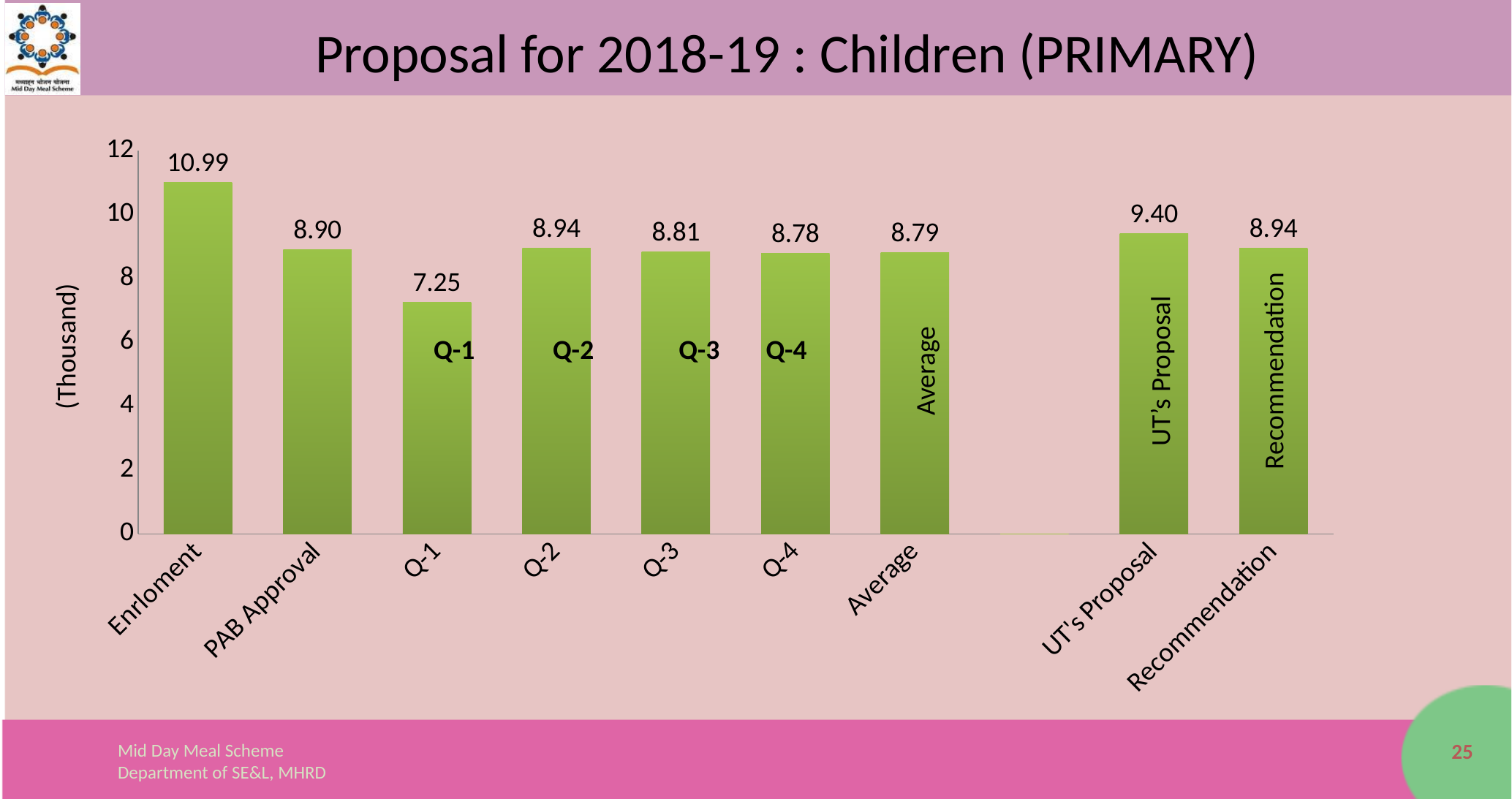
What is the difference between the Enrolment value and the PAB Approval value? 2.09 What is the value for Recommendation? 8.94 What is the label on the vertical axis? (Thousand) Which category has the lowest value? Q-1 What is the value for UT's Proposal? 9.40 What is the value for Enrolment? 10.99 What is the value for PAB Approval? 8.90 How many labelled categories are shown on the x axis? 9 Which category has the highest value? Enrolment Which is larger, the value for UT's Proposal or the value for Recommendation? UT's Proposal What kind of chart is shown on the slide? Bar chart What is the value for Q-1? 7.25